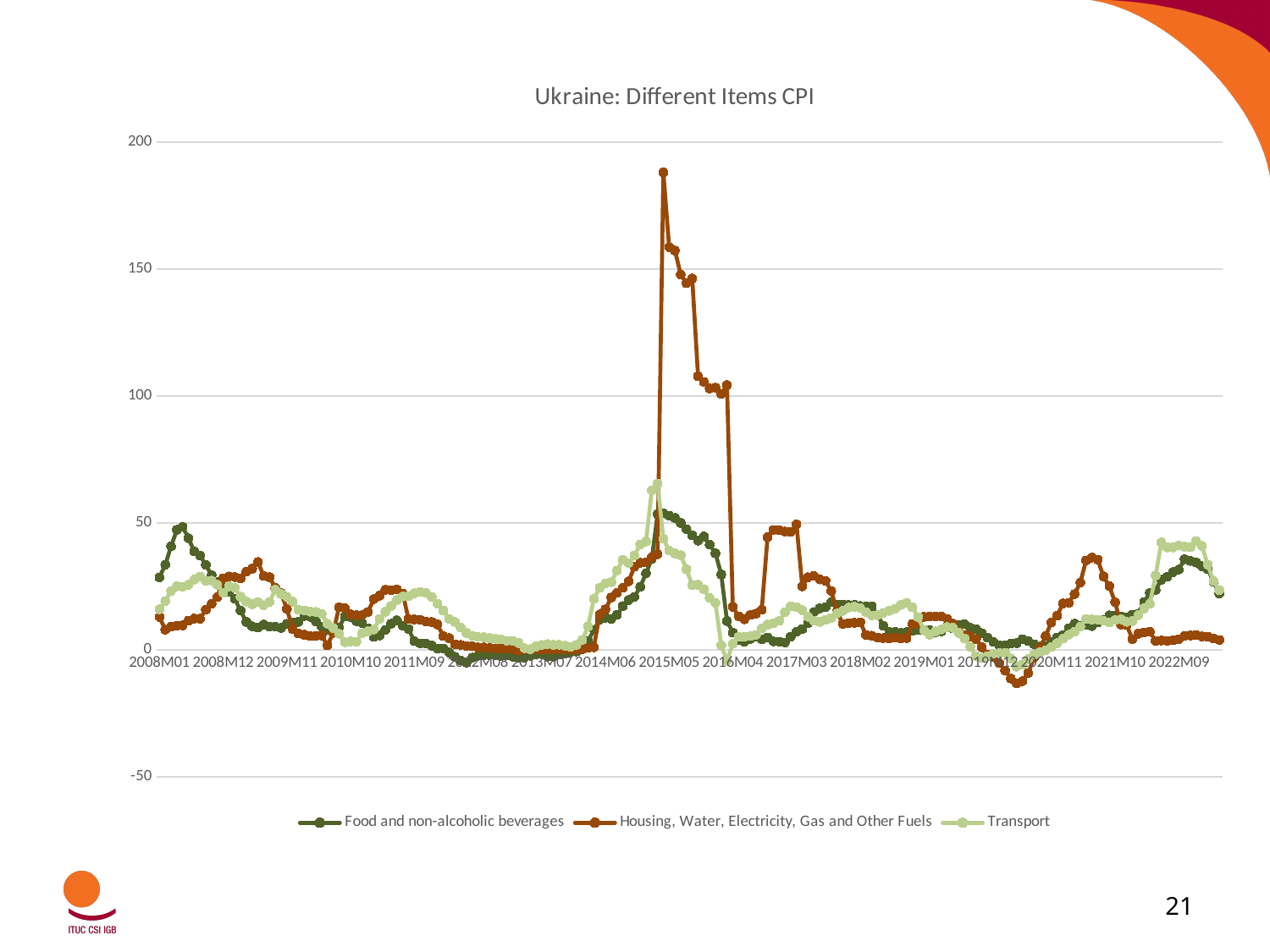
Is the peak value of the Transport series around 2015M05 greater or less than 50? greater Around 2015M05, which series is higher: Housing, Water, Electricity, Gas and Other Fuels or Food and non-alcoholic beverages? Housing, Water, Electricity, Gas and Other Fuels Which series is drawn in the light green line? Transport Which series drops to the lowest value on the chart? Housing, Water, Electricity, Gas and Other Fuels Is the lowest value of the Housing, Water, Electricity, Gas and Other Fuels series, reached around 2020, greater or less than 0? less How many date labels are shown on the x axis? 17 How many series does the legend list? 3 Which series reaches the highest peak on the chart? Housing, Water, Electricity, Gas and Other Fuels What is the title of the chart? Ukraine: Different Items CPI Does the Food and non-alcoholic beverages series rise or fall between 2021M10 and 2022M09? rise Is the peak value of the Housing, Water, Electricity, Gas and Other Fuels series greater or less than 150? greater What kind of chart is shown on the slide? Line chart